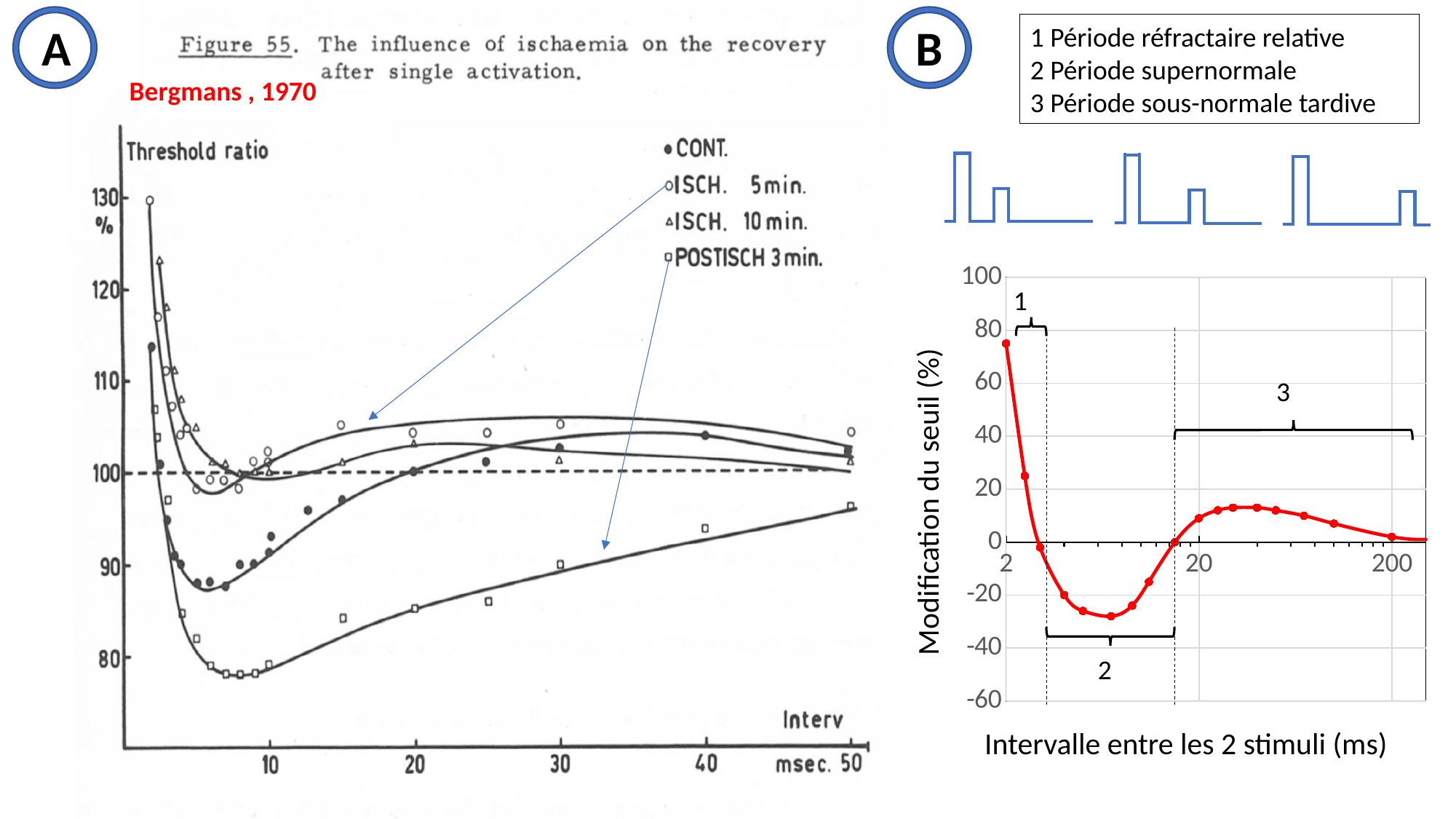
What kind of chart is chart A (Figure 55, on the left)? line chart In chart B (the red line chart on the right), does the curve rise or fall between 2 ms and about 5 ms? fall In chart A (Figure 55), at 5 msec, which is larger: the CONT. value or the POSTISCH 3 min. value? CONT. In chart A (Figure 55), is the CONT. value at 40 msec greater or less than 100? greater In chart A (Figure 55), is the POSTISCH 3 min. value at 10 msec greater or less than 90? less What is the y-axis label of chart B (the red line chart on the right)? Modification du seuil (%) In chart B (the red line chart on the right), is the value at 200 ms greater or less than 20? less In chart A (Figure 55), at what threshold ratio is the horizontal dashed line drawn? 100 In chart A (Figure 55), which series reaches the lowest threshold ratio? POSTISCH 3 min. How many series does the legend of chart A (Figure 55) list? 4